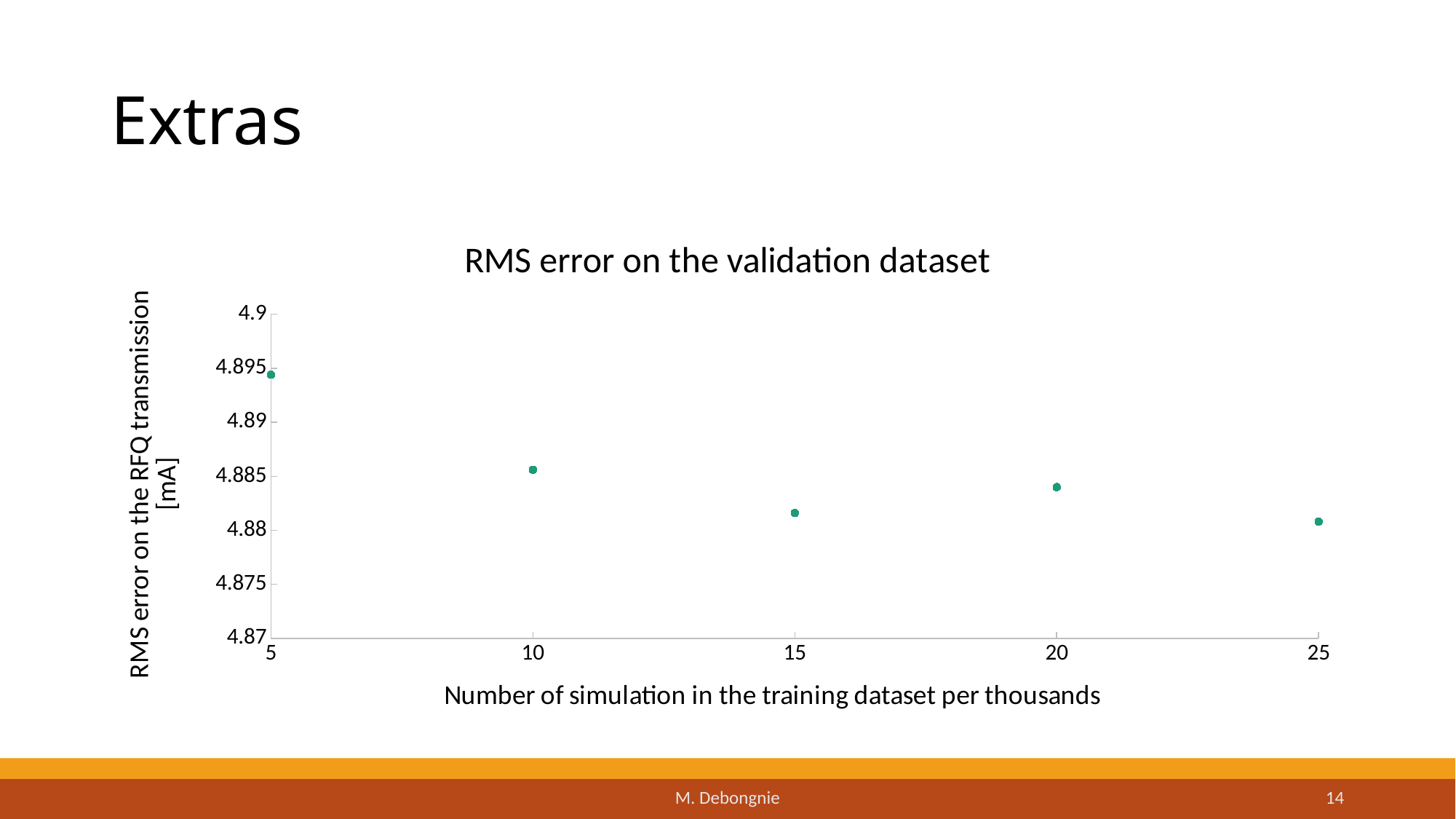
Which has a larger RMS error: 5 thousand or 10 thousand simulations? 5 thousand What kind of chart is shown on the slide? scatter chart At which number of simulations (per thousands) is the RMS error highest? 5 Is the RMS error at 5 thousand simulations greater or less than 4.89? greater Is the RMS error at 20 thousand simulations greater or less than 4.885? less What is the title of the chart? RMS error on the validation dataset Does the RMS error generally rise or fall as the number of simulations increases? fall Is the RMS error at 15 thousand simulations greater or less than 4.88? greater What is the label of the x axis? Number of simulation in the training dataset per thousands How many data points are plotted in the chart? 5 Which has a larger RMS error: 20 thousand or 25 thousand simulations? 20 thousand